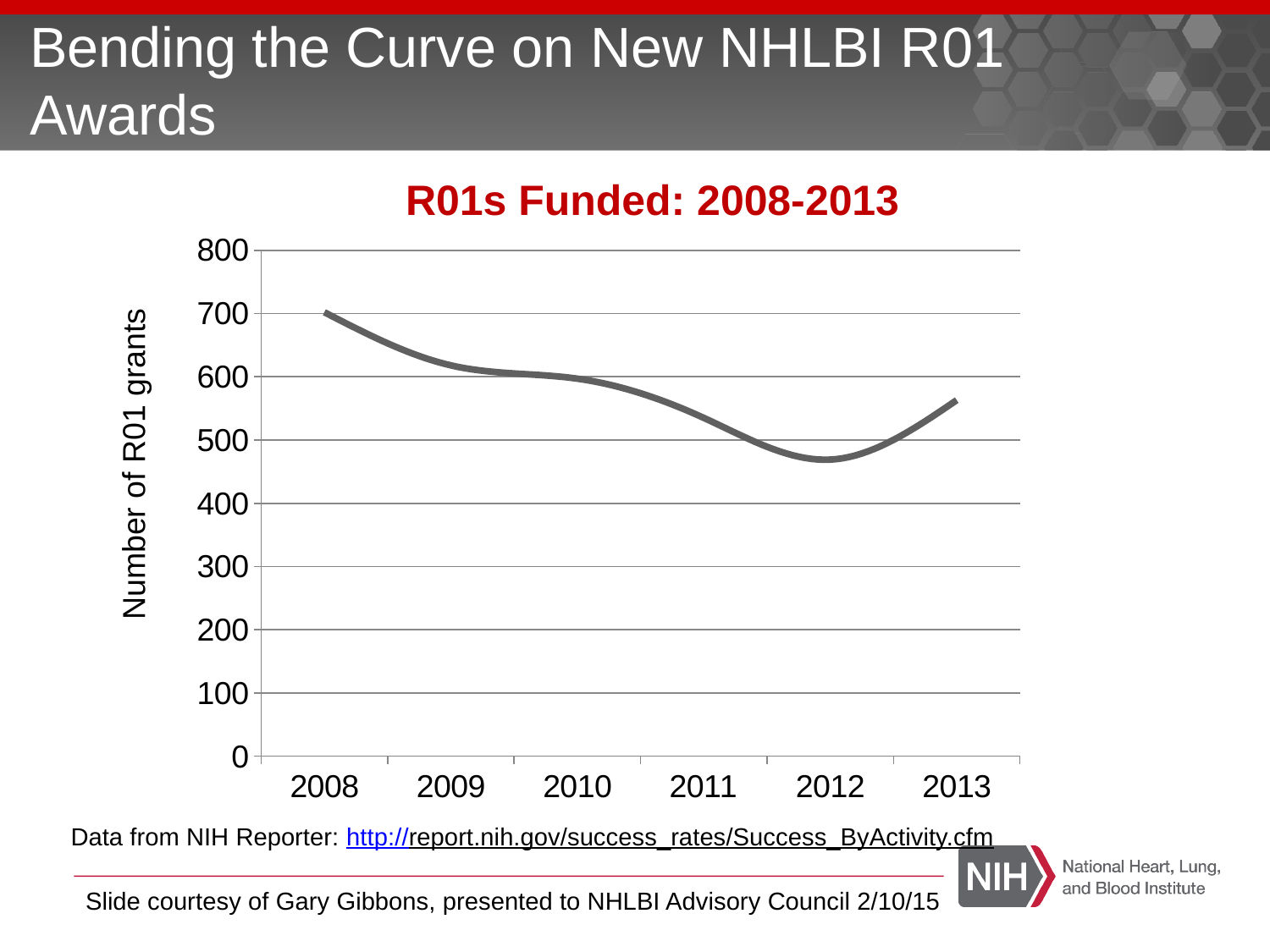
Is the value for 2011 greater or less than 600? less What kind of chart is shown on the slide? line chart Is the value for 2009 greater or less than 600? greater Is the value for 2012 greater or less than 500? less What is the label on the vertical axis of the chart? Number of R01 grants Which year has the highest number of R01 grants? 2008 Does the number of R01 grants rise or fall from 2008 to 2012? fall How many years are shown along the x axis of the chart? 6 Which year has the lowest number of R01 grants? 2012 What is the title of the chart? R01s Funded: 2008-2013 Which year has more R01 grants, 2013 or 2012? 2013